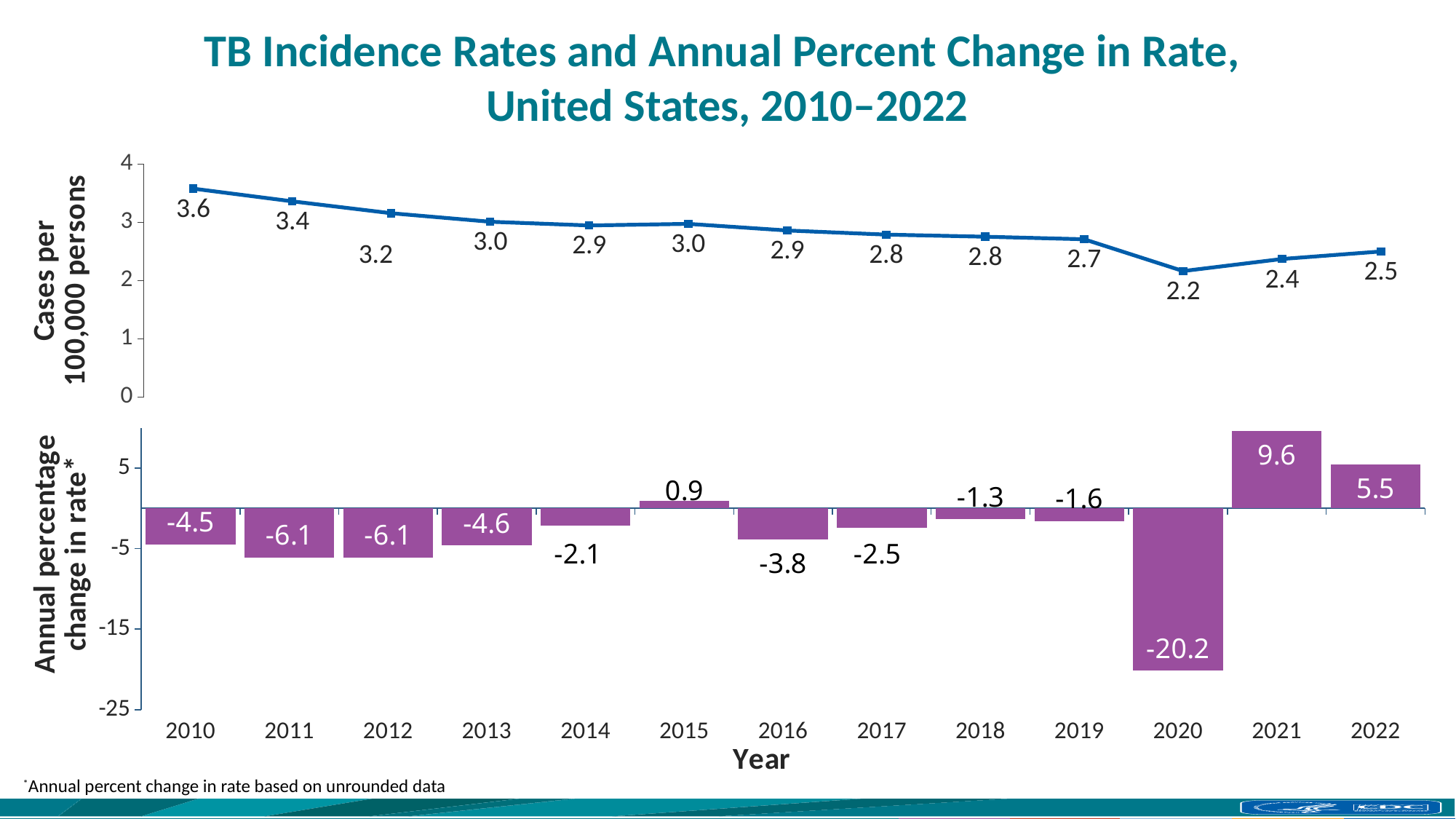
In the top chart (cases per 100,000 persons), what is the difference between the 2010 value and the 2022 value? 1.1 In the bottom chart (annual percentage change in rate), what is the value for 2020? -20.2 In the top chart (cases per 100,000 persons), what is the value for 2020? 2.2 In the top chart (cases per 100,000 persons), which year has the highest value? 2010 In the bottom chart (annual percentage change in rate), how many years are plotted? 13 In the bottom chart (annual percentage change in rate), which year has the highest value? 2021 In the bottom chart (annual percentage change in rate), which is larger, the value for 2015 or the value for 2016? 2015 In the bottom chart (annual percentage change in rate), what kind of chart is shown? Bar chart In the bottom chart (annual percentage change in rate), what is the value for 2021? 9.6 In the top chart (cases per 100,000 persons), what is the value for 2010? 3.6 In the top chart (cases per 100,000 persons), which year has the lowest value? 2020 In the top chart (cases per 100,000 persons), what kind of chart is shown? Line chart